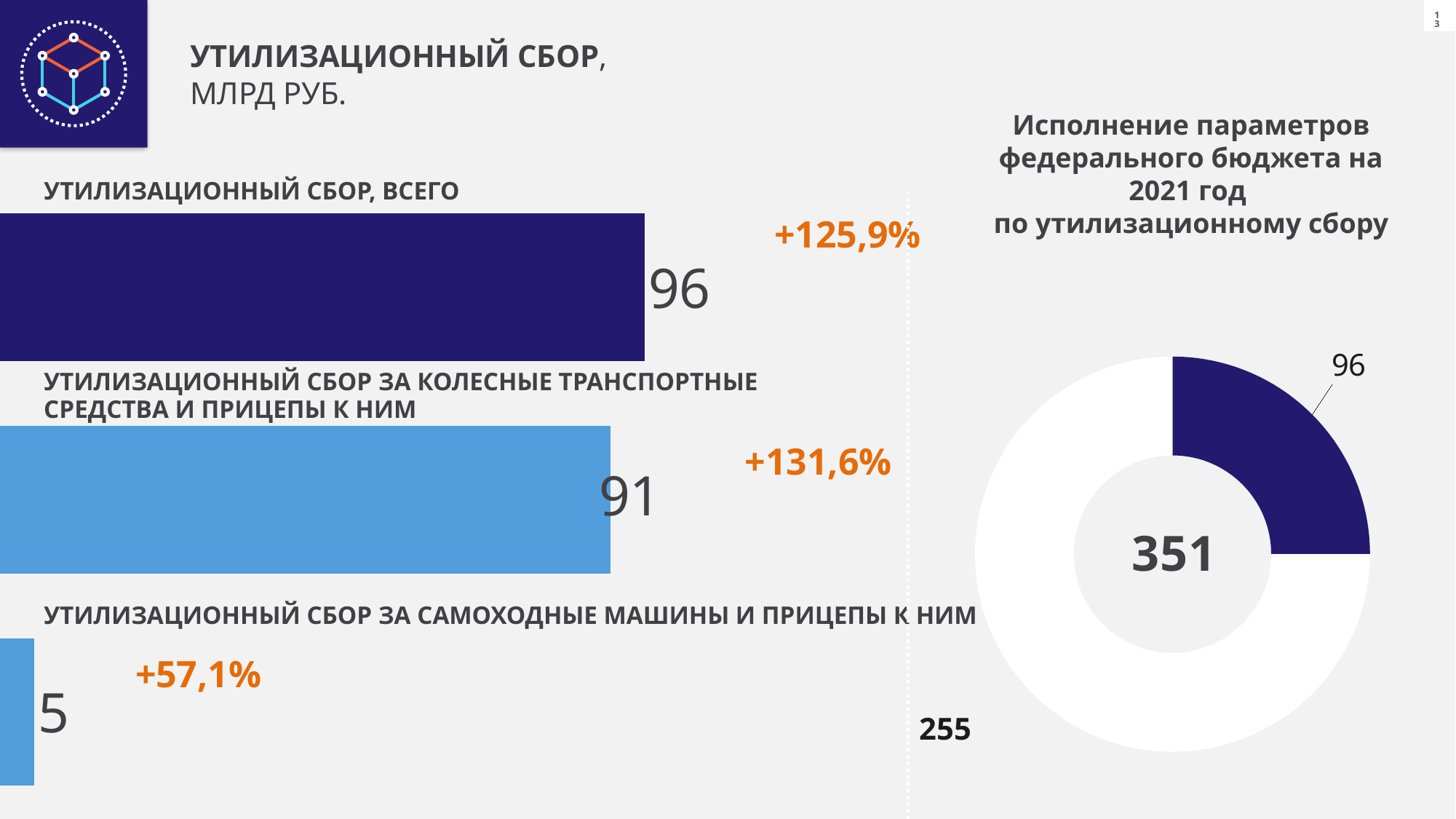
In the bar chart on the left, what is the value for «Утилизационный сбор за колесные транспортные средства и прицепы к ним»? 91 What kind of chart is shown on the left side of the slide? Bar chart What total is shown in the centre of the donut chart on the right? 351 In the bar chart on the left, which is larger: the value for колесные транспортные средства or the value for самоходные машины? Колесные транспортные средства In the bar chart on the left, what is the value for «Утилизационный сбор за самоходные машины и прицепы к ним»? 5 How many bars are shown in the bar chart on the left? 3 What kind of chart is shown under the title «Исполнение параметров федерального бюджета на 2021 год по утилизационному сбору»? Donut (pie) chart In the bar chart on the left, what is the value for «Утилизационный сбор, всего»? 96 In the bar chart on the left, which category has the lowest value? Утилизационный сбор за самоходные машины и прицепы к ним In the donut chart on the right, what value is labelled on the dark blue segment? 96 In the donut chart on the right, what value is labelled on the white segment? 255 In the bar chart on the left, what is the difference between the value for «Утилизационный сбор, всего» and the value for колесные транспортные средства и прицепы к ним? 5